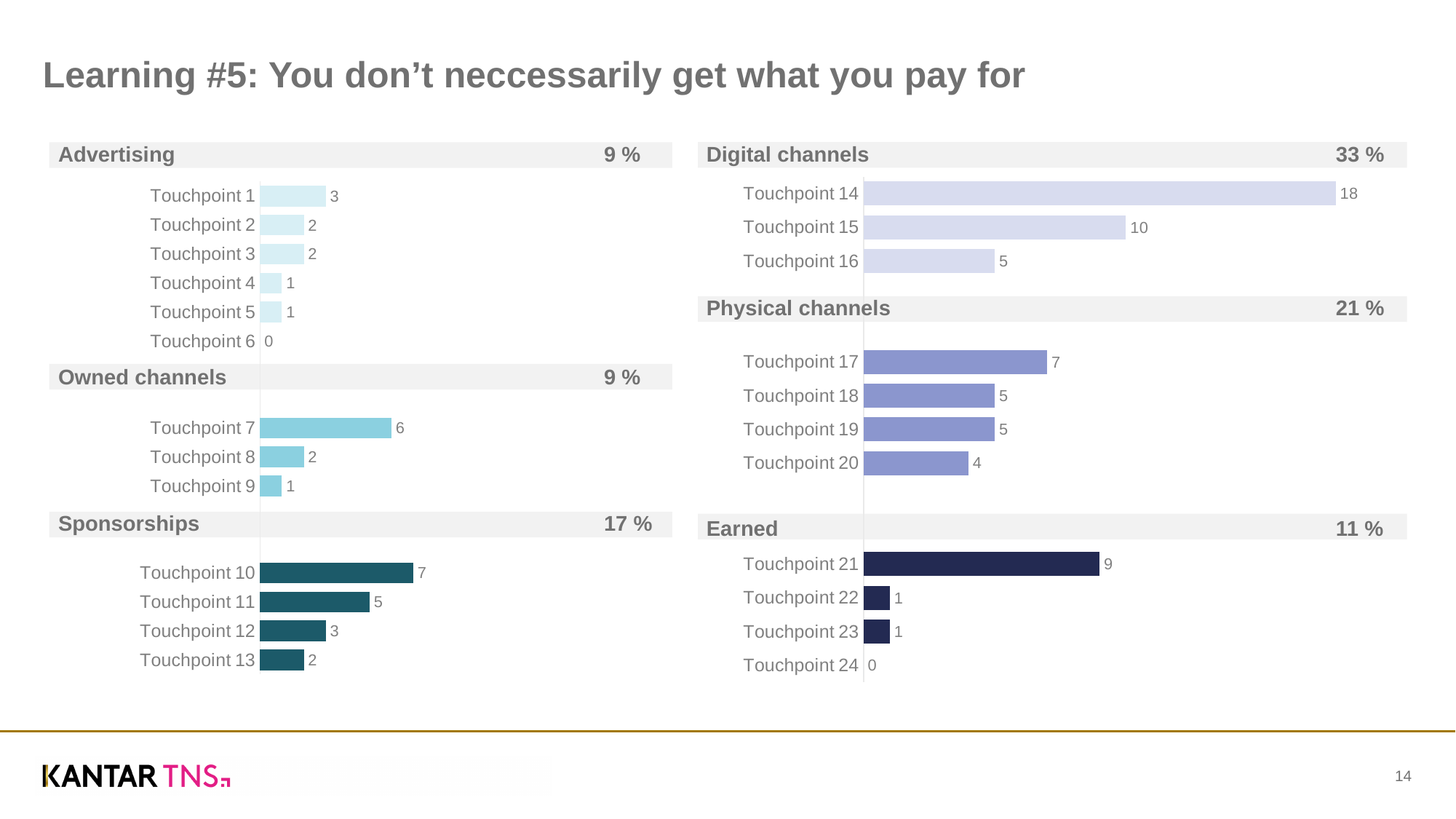
What kind of chart is used for the Physical channels section? Bar chart What percentage is shown in the header of the Sponsorships section? 17 % In the Earned chart, which is larger, Touchpoint 21 or Touchpoint 22? Touchpoint 21 What percentage is shown in the header of the Digital channels section? 33 % In the Advertising chart, what is the value for Touchpoint 1? 3 In the Digital channels chart, what is the value for Touchpoint 15? 10 How many touchpoints are shown in the Advertising chart? 6 In the Owned channels chart, what is the value for Touchpoint 7? 6 In the Physical channels chart, what is the difference between Touchpoint 17 and Touchpoint 20? 3 In the Sponsorships chart, which touchpoint has the lowest value? Touchpoint 13 In the Digital channels chart, which touchpoint has the highest value? Touchpoint 14 How many touchpoints are shown in the Owned channels chart? 3